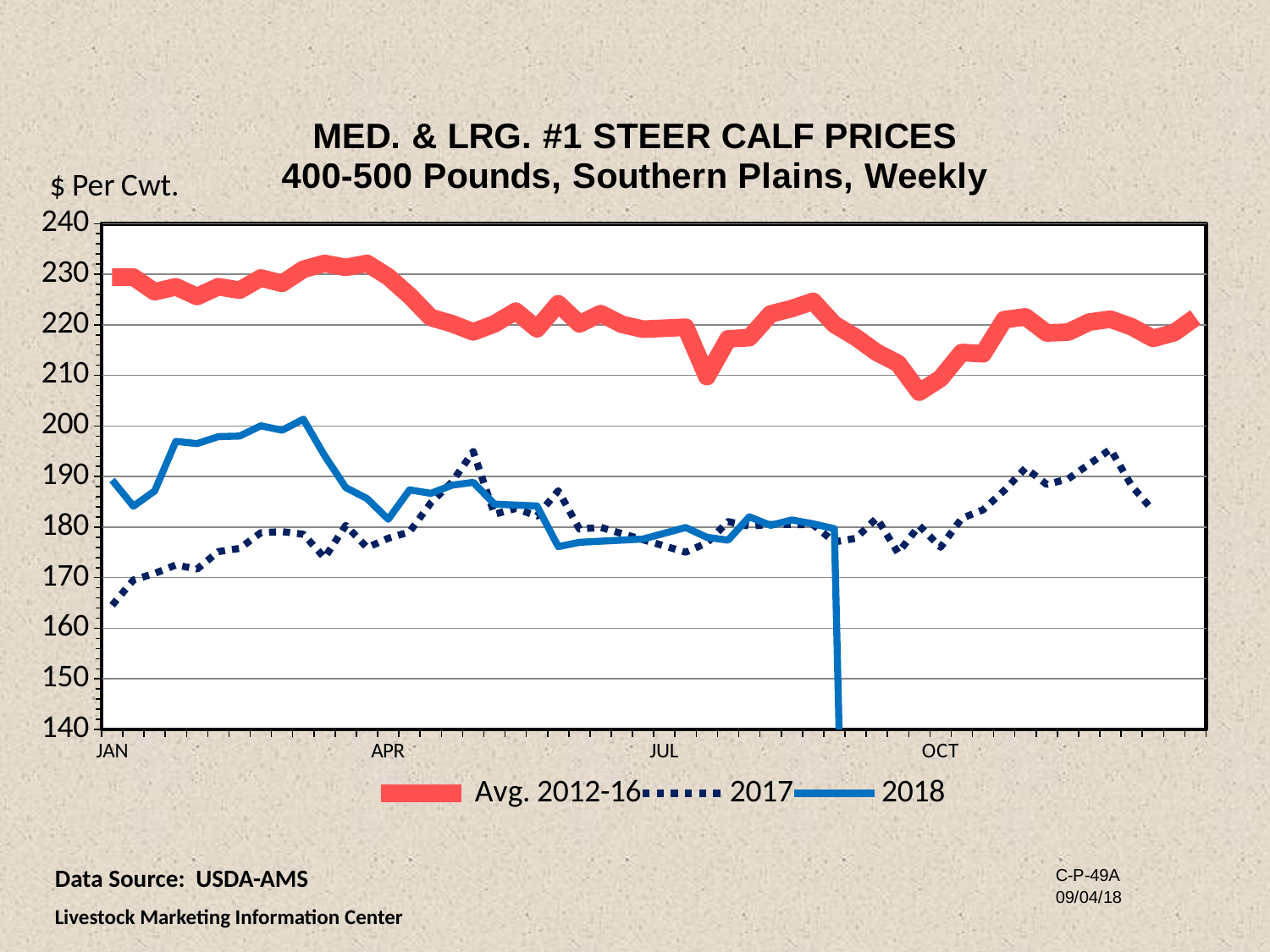
Which series is higher in JAN, Avg. 2012-16 or 2017? Avg. 2012-16 Is the value for 2017 in JAN greater or less than 170? less How many series does the legend list? 3 Does the 2017 series rise or fall from JAN to APR? rise Which series is higher in JAN, 2018 or 2017? 2018 Is the value for Avg. 2012-16 in JAN greater or less than 220? greater What is the label on the vertical axis of the chart? $ Per Cwt. Which series has the highest values across the whole year? Avg. 2012-16 What are the three series listed in the legend? Avg. 2012-16, 2017, 2018 Is the value for 2018 in JAN greater or less than 180? greater What kind of chart is shown on the slide? line chart